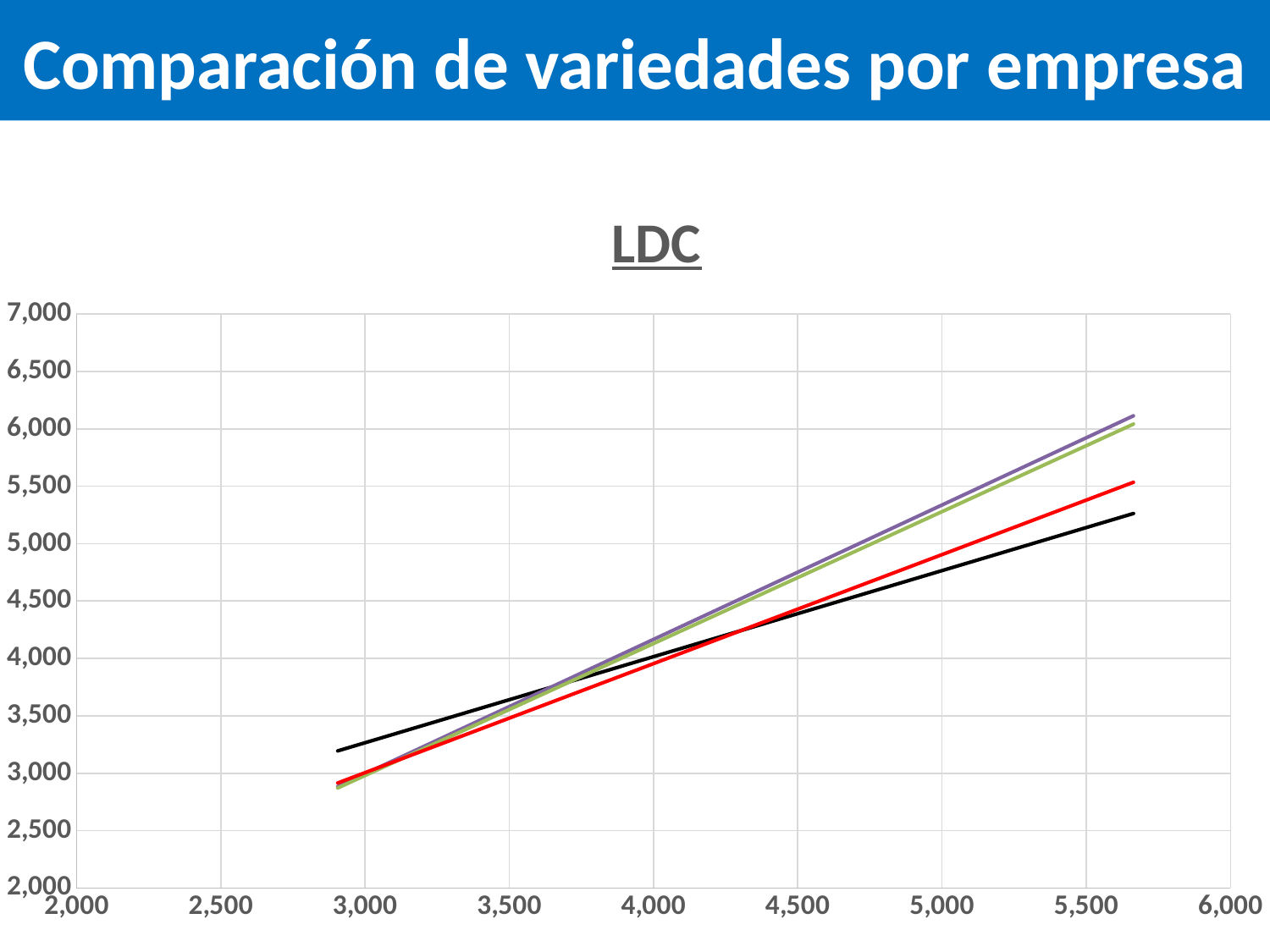
Do the lines rise or fall as the x-axis value increases? rise Is the value of the purple line at x = 5,500 greater or less than 5,500? greater Which line is the highest at the left-hand end of the chart? the black line Is the starting value of the black line greater or less than 3,000? greater What kind of chart is shown on the slide? line chart Which line is the lowest at the right-hand end of the chart? the black line What is the title of the chart? LDC At x = 3,000, is the black line or the red line higher? the black line What is the highest value shown on the vertical axis? 7,000 At x = 5,500, is the purple line or the black line higher? the purple line How many lines are plotted on the chart? 4 Is the value of the black line at x = 5,000 greater or less than 5,000? less